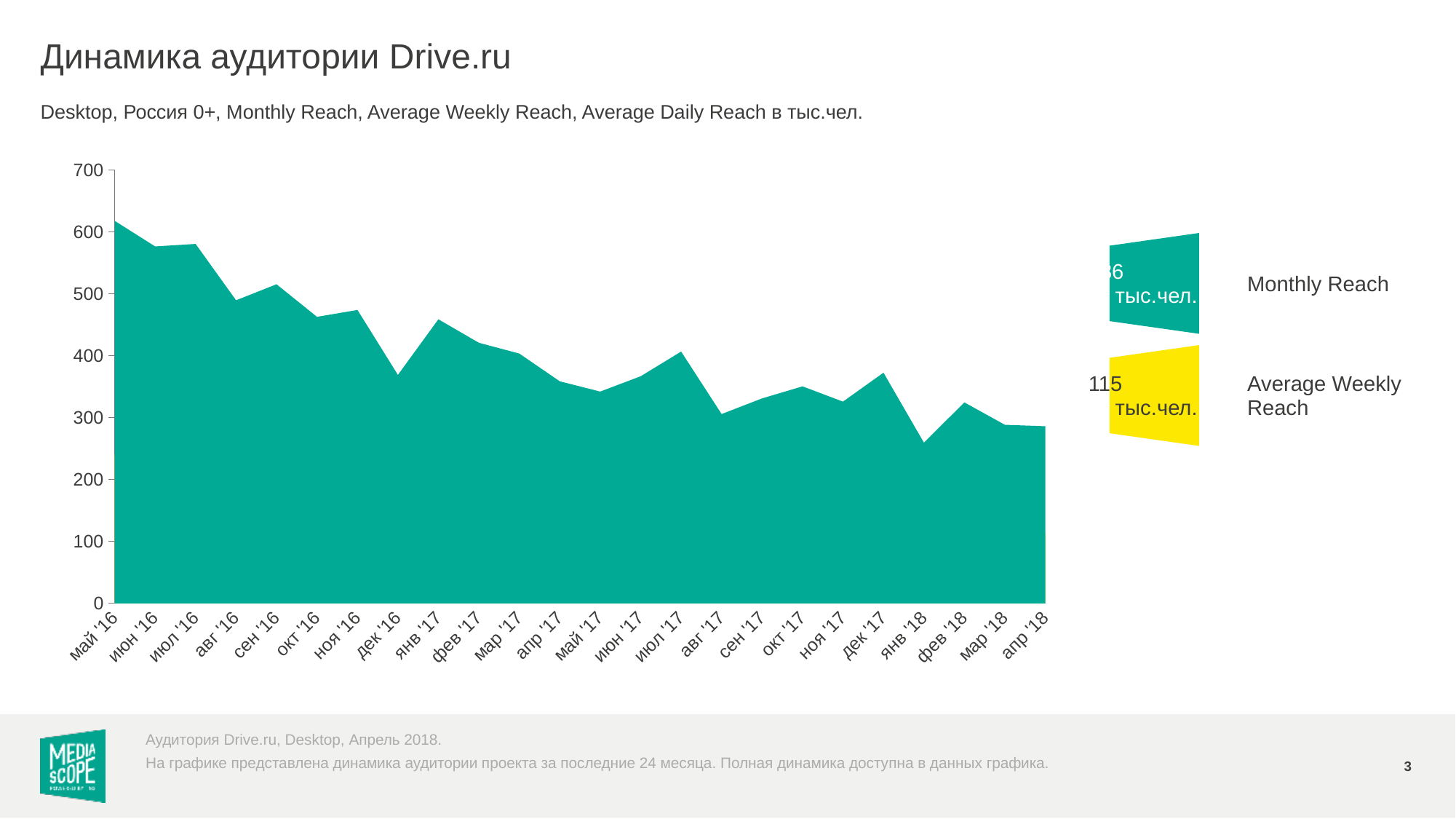
Is the value for дек '16 greater or less than 400? less Is the value for май '16 greater or less than 500? greater Which is larger, the value for май '16 or the value for апр '18? май '16 Which month has the highest value on the chart? май '16 How many monthly data points are plotted on the chart? 24 Which month has the lowest value on the chart? янв '18 Is the value for янв '18 greater or less than 300? less What is the title of the slide? Динамика аудитории Drive.ru What kind of chart is shown on the slide? area chart Overall, do the values rise or fall from май '16 to апр '18? fall What Average Weekly Reach value is shown in the yellow box next to the chart? 115 тыс.чел.